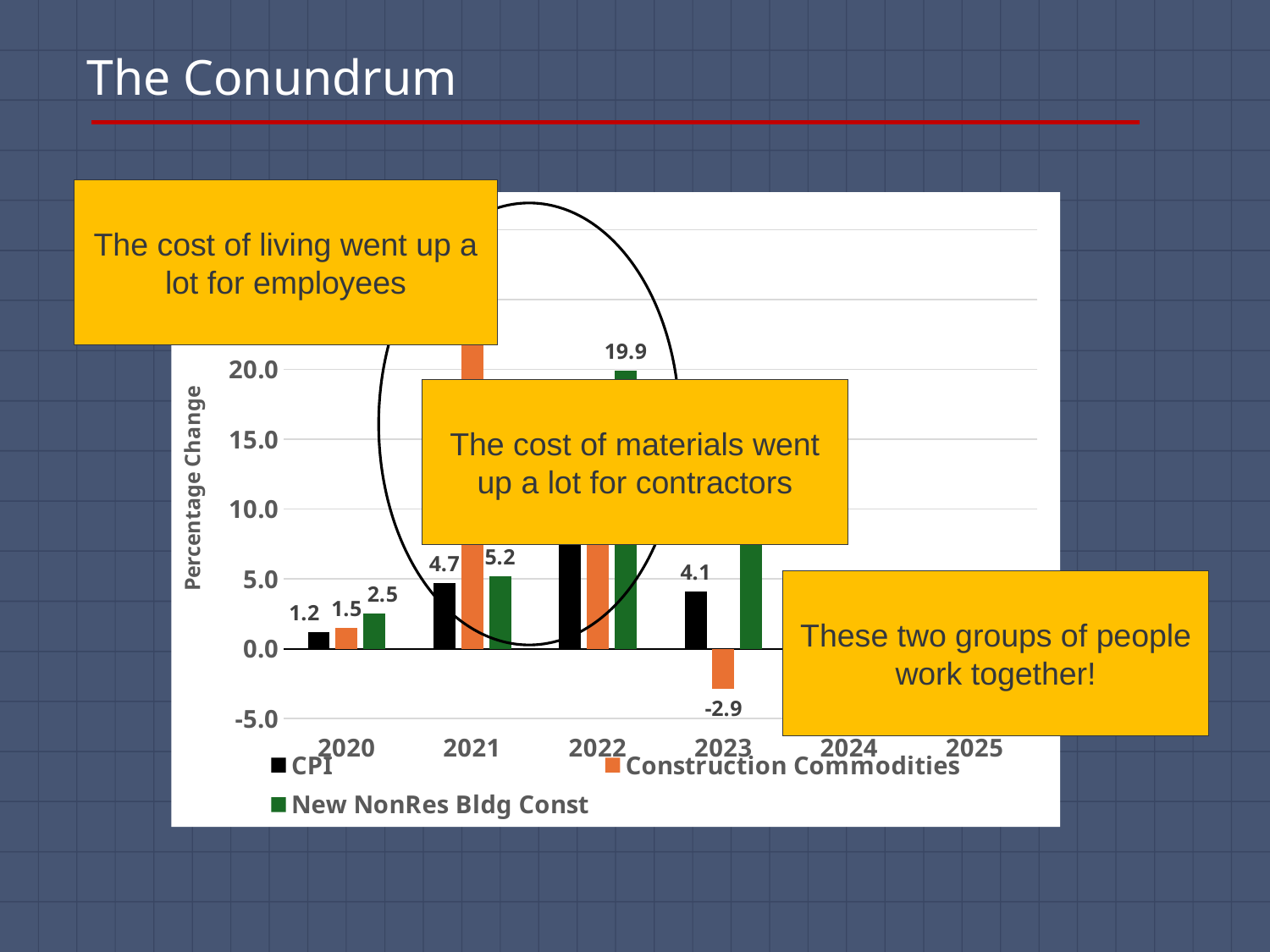
What is the CPI value for 2020? 1.2 Is the Construction Commodities value for 2021 greater or less than 20.0? greater What is the Construction Commodities value for 2023? -2.9 Which series has the lowest value in 2023? Construction Commodities What is the difference between the New NonRes Bldg Const value and the CPI value in 2020? 1.3 What is the CPI value for 2021? 4.7 What is the New NonRes Bldg Const value for 2022? 19.9 Which is larger, the CPI value for 2021 or the CPI value for 2023? 2021 How many series does the legend list? 3 What kind of chart is shown on the slide? bar chart What is the Construction Commodities value for 2020? 1.5 What is the title of the vertical axis? Percentage Change